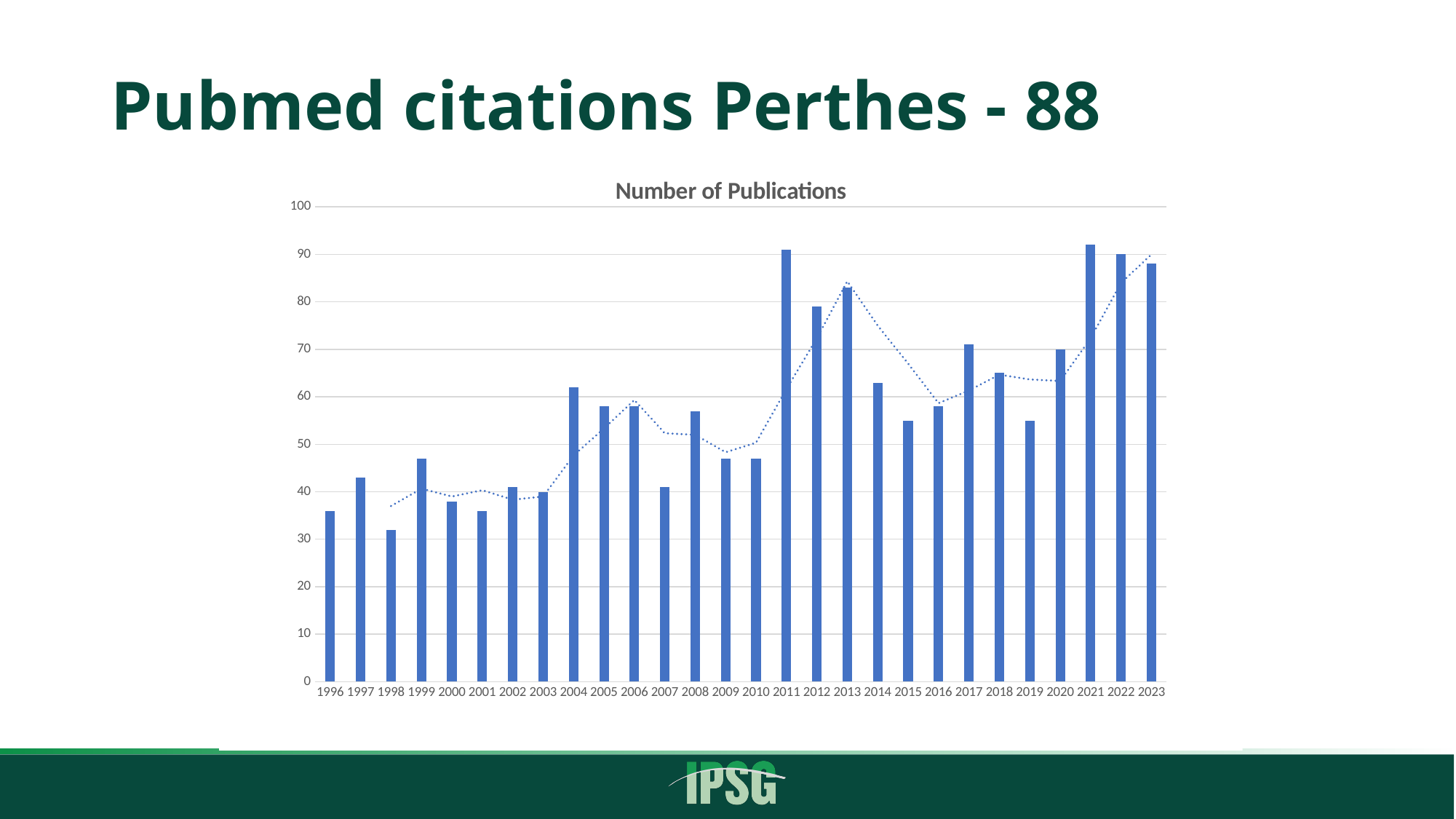
Is the value for 2009 greater or less than 50? less Which year has more publications, 2003 or 2004? 2004 Is the value for 2013 greater or less than 80? greater How many years are shown on the x axis of the chart? 28 What is the title of the chart? Number of Publications Is the value for 2015 greater or less than 60? less What kind of chart is shown on the slide? bar chart Which year has more publications, 2011 or 2012? 2011 Overall, do the number of publications rise or fall from 1996 to 2023? rise Which year has the lowest number of publications? 1998